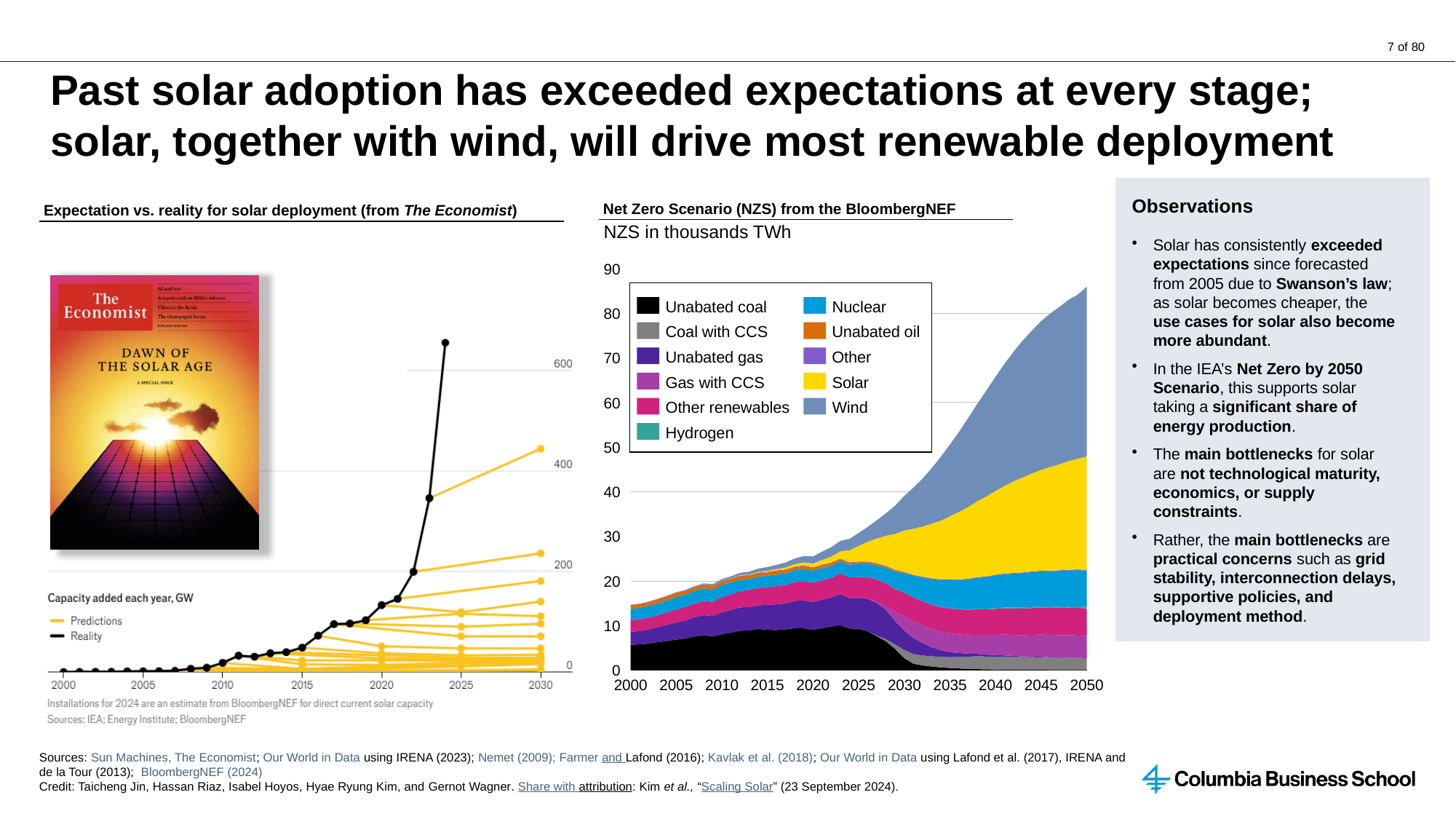
In the Net Zero Scenario (NZS) chart, does the total stacked value rise or fall from 2000 to 2050? rise In the Expectation vs. reality for solar deployment chart, is the Reality value for 2024 greater or less than 600? greater What kind of chart is the Net Zero Scenario (NZS) from the BloombergNEF chart? stacked area chart What kind of chart is the Expectation vs. reality for solar deployment chart on the left? line chart In the Net Zero Scenario (NZS) chart, is the total stacked value in 2000 greater or less than 20? less How many series does the legend of the Expectation vs. reality for solar deployment chart list? 2 In the Net Zero Scenario (NZS) chart, which is larger in 2050, Wind or Solar? Wind In the Net Zero Scenario (NZS) chart, is the total stacked value in 2050 greater or less than 80? greater How many year ticks are labelled on the x axis of the Net Zero Scenario (NZS) chart? 11 In the Net Zero Scenario (NZS) chart, which series has the largest share of the stack in 2050? Wind How many series does the legend of the Net Zero Scenario (NZS) chart list? 11 In the Net Zero Scenario (NZS) chart, what unit are the values expressed in? thousands TWh